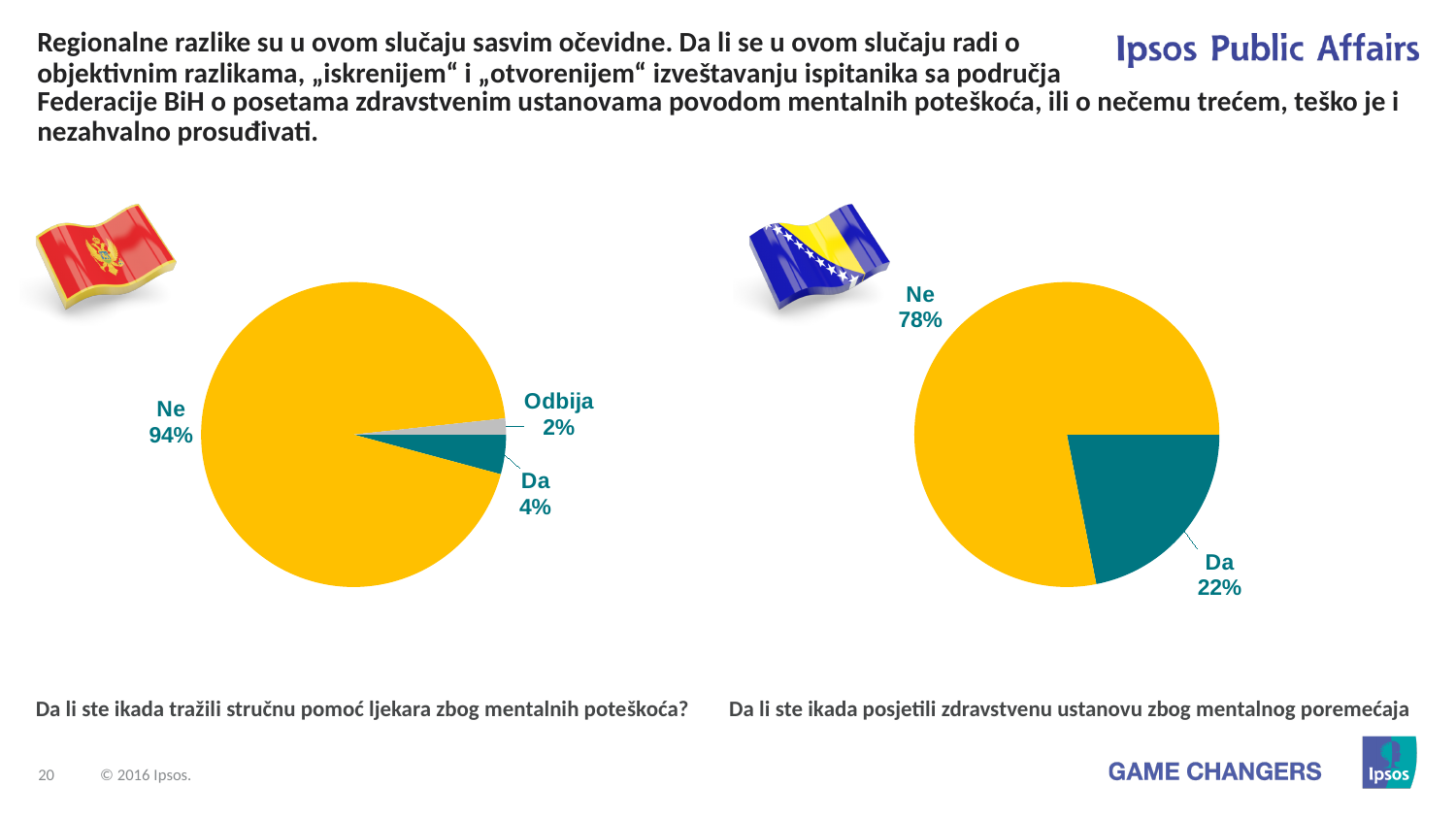
In the right pie chart, what share of respondents answered "Ne"? 78% What is the difference between the "Ne" share in the left pie chart and the "Ne" share in the right pie chart? 16 percentage points How many slices does the left pie chart have? 3 Which chart has the larger "Da" share, the left pie chart or the right pie chart? The right pie chart How many slices does the right pie chart have? 2 In the left pie chart, what share of respondents answered "Da"? 4% In the right pie chart, which category has the largest share? Ne In the left pie chart, what share of respondents answered "Ne"? 94% In the right pie chart, what share of respondents answered "Da"? 22% In the left pie chart, what share is labelled "Odbija"? 2% What type of chart is used on this slide? Pie chart In the left pie chart, which category has the smallest share? Odbija